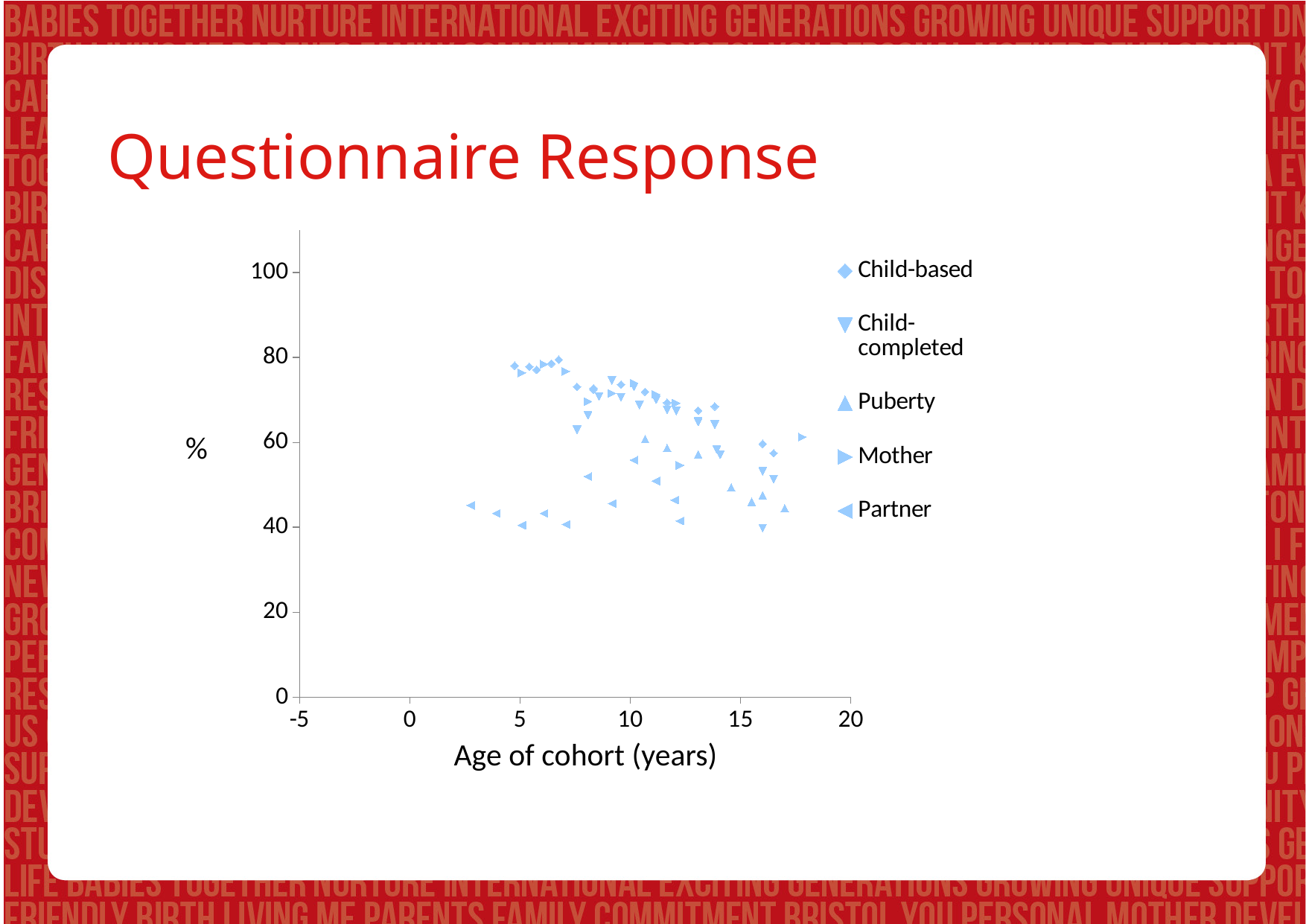
What kind of chart is shown on the slide? Scatter chart Which is larger: the Child-based value at age 5 or the Partner value at age 3? Child-based at age 5 Is the Partner value at age 3 greater or less than 60? less Is the Child-based value at age 5 greater or less than 60? greater Is the Partner value at age 5 greater or less than 20? greater Which series has the highest values on the chart? Child-based What is the label of the x axis? Age of cohort (years) Do the Child-based values rise or fall as the age of cohort increases? fall How many series does the legend list? 5 What is the title of the chart? Questionnaire Response